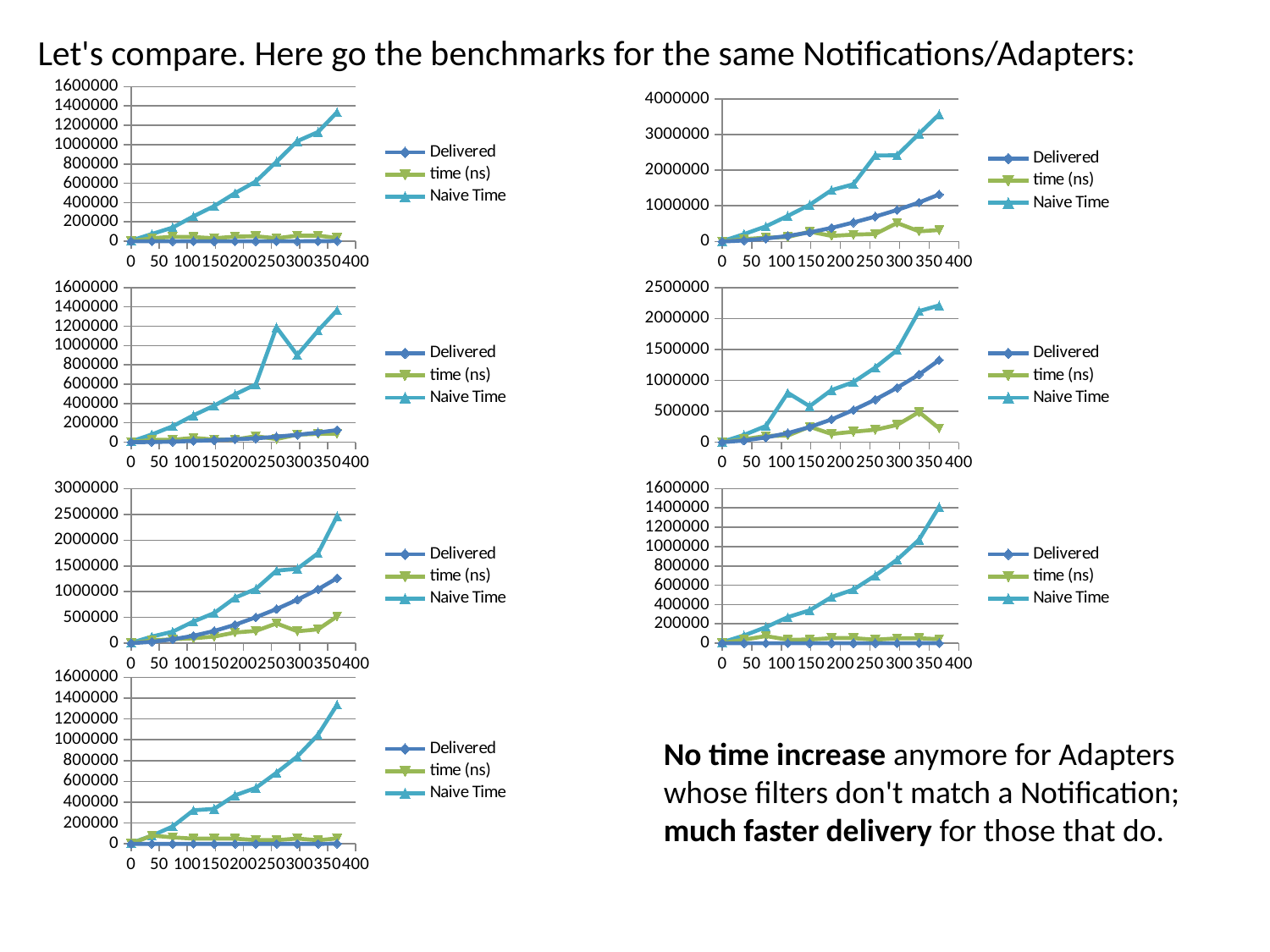
How many charts are shown on the slide? 7 In the third chart from the top in the left column, which series reaches the highest value? Naive Time In the top-right chart, is the Naive Time value at x = 350 greater or less than 3000000? greater In the top-right chart, at x = 350, which is larger: Naive Time or Delivered? Naive Time What are the three legend entries of the top-right chart? Delivered, time (ns), Naive Time In the top-left chart, does the Naive Time series rise or fall as x increases from 0 to 350? rise How many series does the legend of the top-left chart list? 3 In the top-left chart, is the Naive Time value at x = 350 greater or less than 1000000? greater What kind of chart is the top-left chart on the slide? line chart In the third chart from the top in the left column, is the Delivered value at x = 350 greater or less than 1000000? greater